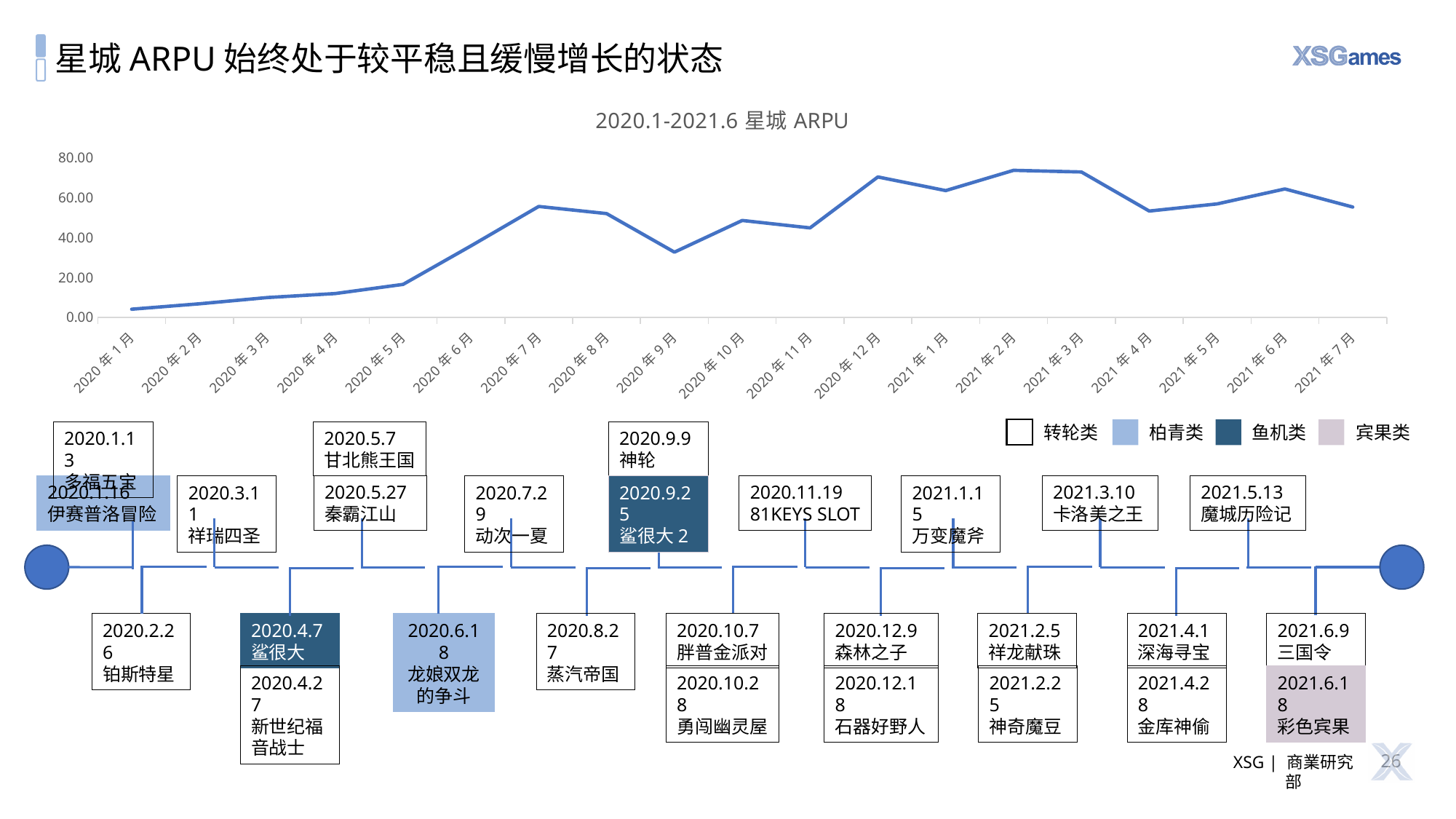
How many monthly data points are plotted on the x axis of the chart? 19 Which month has the lowest ARPU value in the chart? 2020 年 1 月 Is the ARPU value for 2020 年 12 月 greater or less than 60.00? greater Which month has the higher ARPU value, 2020 年 7 月 or 2020 年 5 月? 2020 年 7 月 What is the title of the chart? 2020.1-2021.6 星城 ARPU Overall, does the ARPU line rise or fall from 2020 年 1 月 to 2021 年 7 月? rise Is the ARPU value for 2020 年 9 月 greater or less than 40.00? less Is the ARPU value for 2021 年 4 月 greater or less than 60.00? less What kind of chart is shown on the slide? line chart Which month has the higher ARPU value, 2020 年 12 月 or 2020 年 9 月? 2020 年 12 月